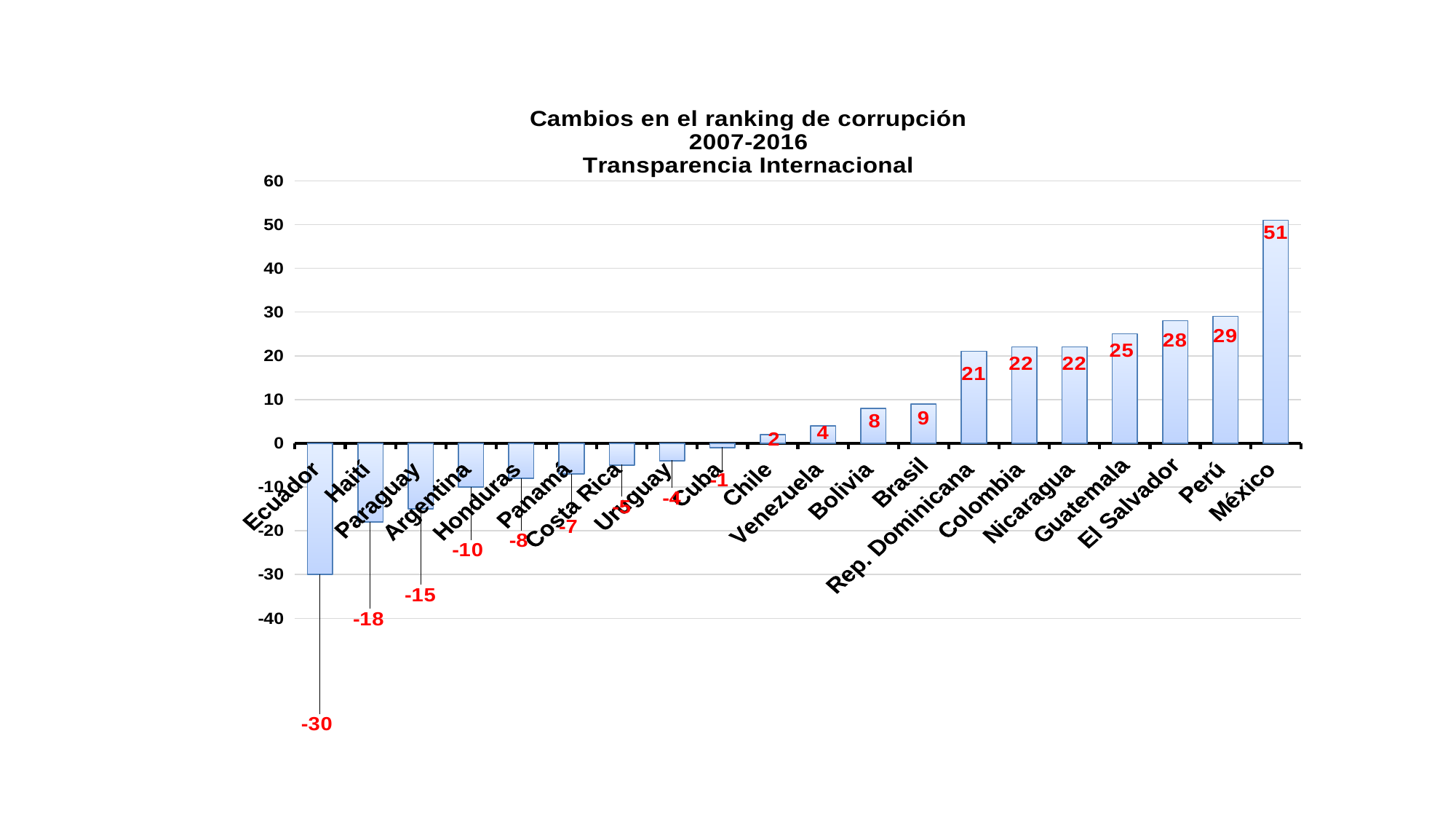
What is the difference between the values for México and Perú? 22 What is the value for Rep. Dominicana? 21 How many countries are shown on the chart? 20 What is the value for Ecuador? -30 Which has a larger value, Guatemala or Brasil? Guatemala Which country has the highest value? México What is the value for México? 51 Is the value for El Salvador greater or less than 20? greater Which country has the lowest value? Ecuador What is the title of the chart? Cambios en el ranking de corrupción 2007-2016 Transparencia Internacional What kind of chart is this? Bar chart What is the value for Haití? -18